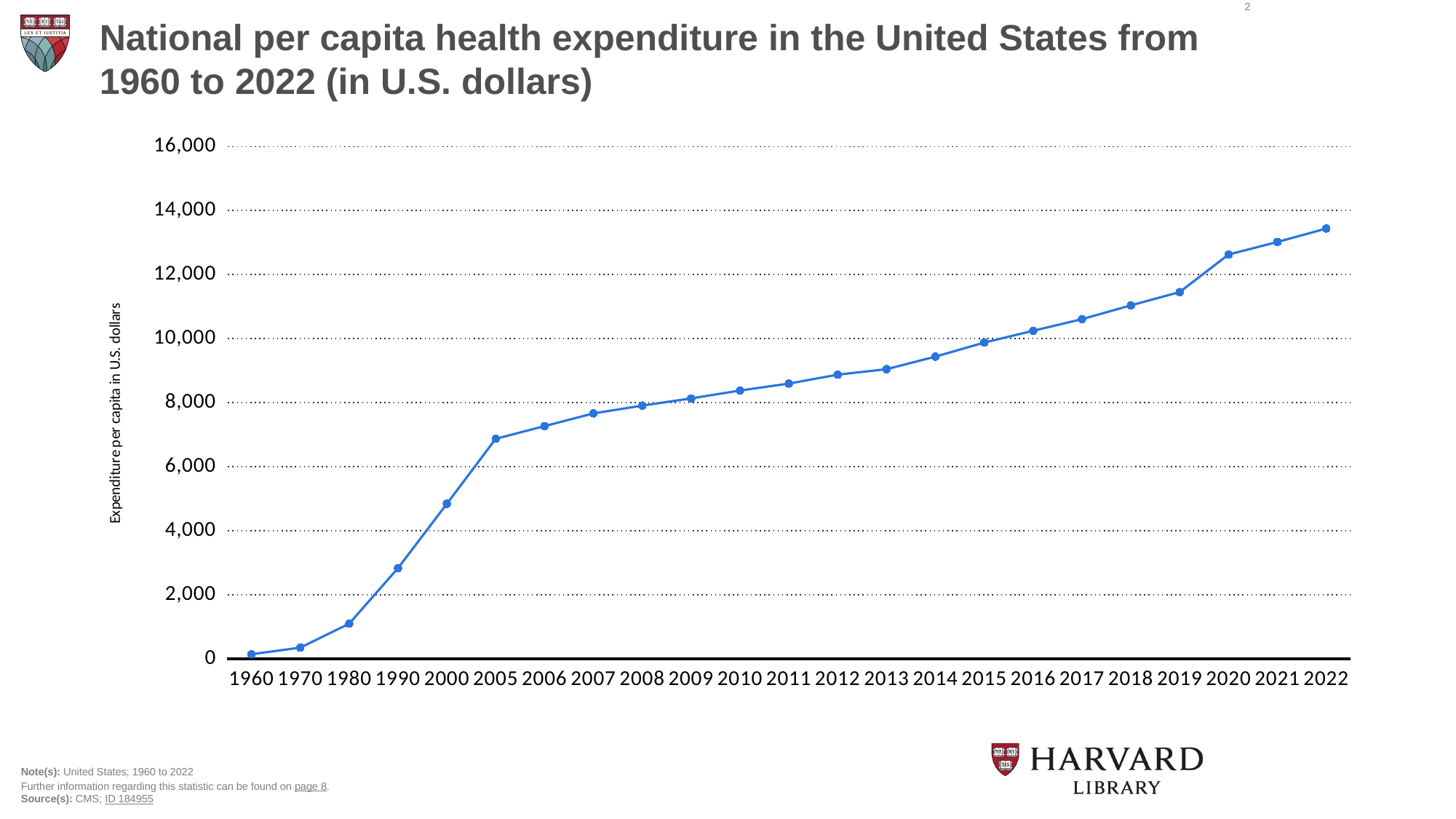
Is the value for 2018 greater or less than 10,000? greater Do the values rise or fall from 1960 to 2022? rise Is the value for 1980 greater or less than 2,000? less Which year has the lowest per capita health expenditure? 1960 Which year has the highest per capita health expenditure? 2022 How many years are plotted on the x axis? 23 Which is larger, the value for 2000 or the value for 2005? 2005 Is the value for 2005 greater or less than 6,000? greater What kind of chart is shown on the slide? line chart What is the label on the vertical axis? Expenditure per capita in U.S. dollars